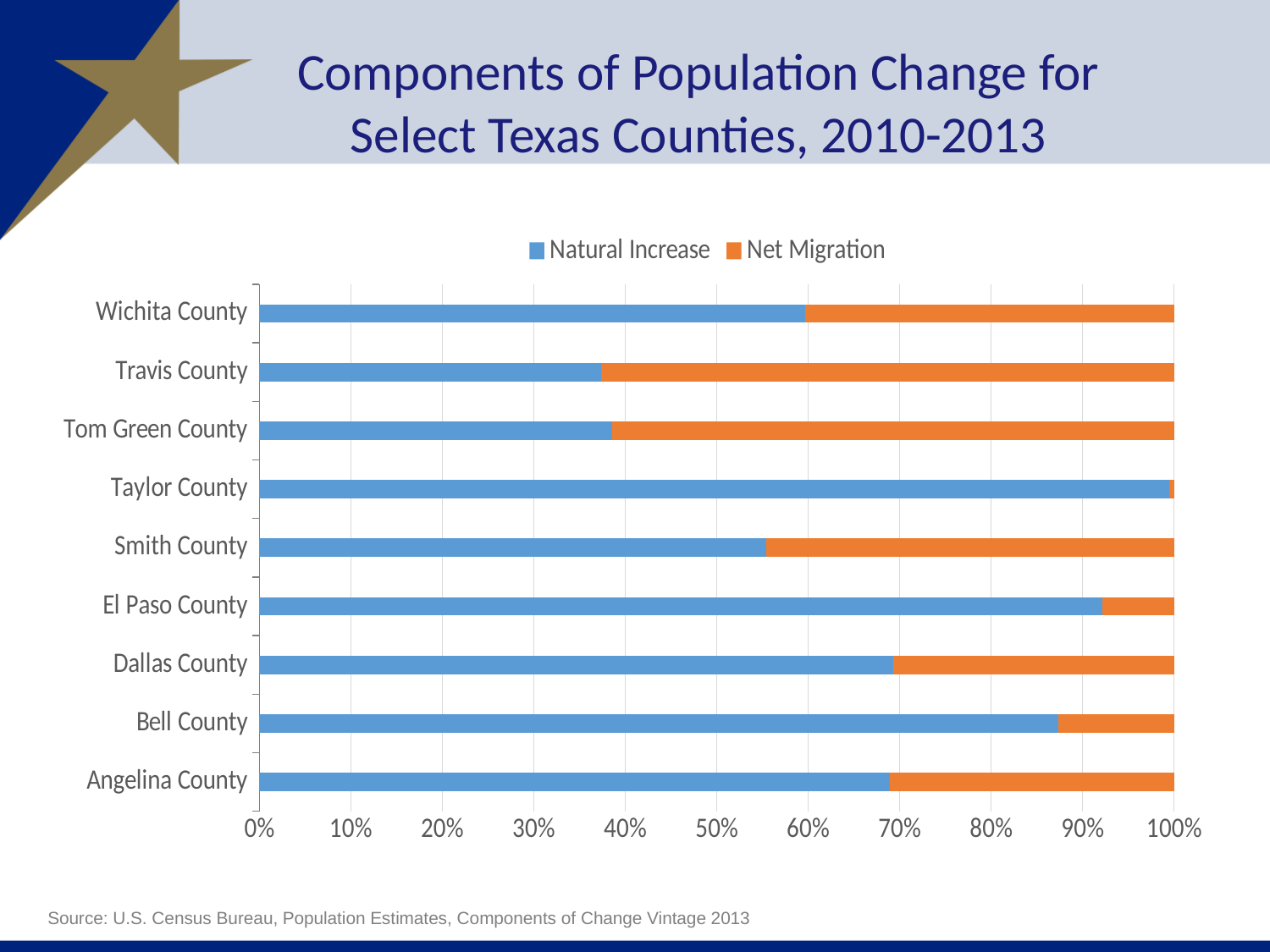
Which colour represents Net Migration in the chart? Orange How many series does the legend list? 2 Which county has the lowest share of Net Migration? Taylor County How many counties are shown on the chart? 9 Is the Natural Increase share for Travis County greater or less than 40%? less Which county has a larger Natural Increase share, Wichita County or Travis County? Wichita County Which county has the highest share of Natural Increase? Taylor County Is the Natural Increase share for Bell County greater or less than 80%? greater What kind of chart is shown on the slide? Stacked bar chart Which county has a larger Natural Increase share, El Paso County or Bell County? El Paso County Is the Natural Increase share for Wichita County greater or less than 50%? greater